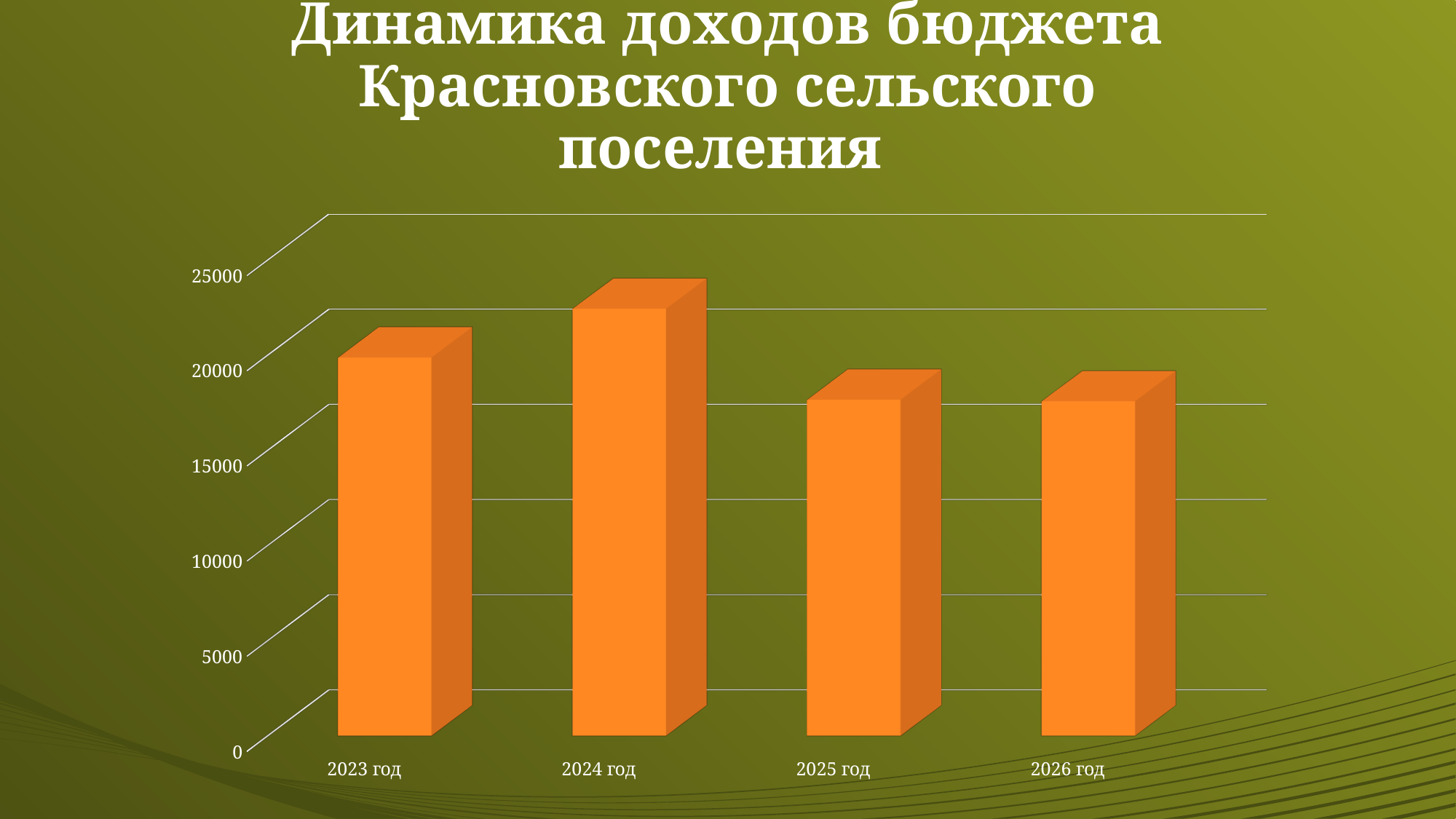
What kind of chart is shown on the slide? bar chart Is the value for 2024 год greater or less than 20000? greater Is the value for 2026 год greater or less than 20000? less Is the value for 2023 год greater or less than 15000? greater Does the value rise or fall from 2024 год to 2025 год? fall Which year has the highest budget income in the chart? 2024 год Which is larger, the value for 2024 год or the value for 2025 год? 2024 год What is the title of the chart on the slide? Динамика доходов бюджета Красновского сельского поселения How many years (categories) are shown on the x axis of the chart? 4